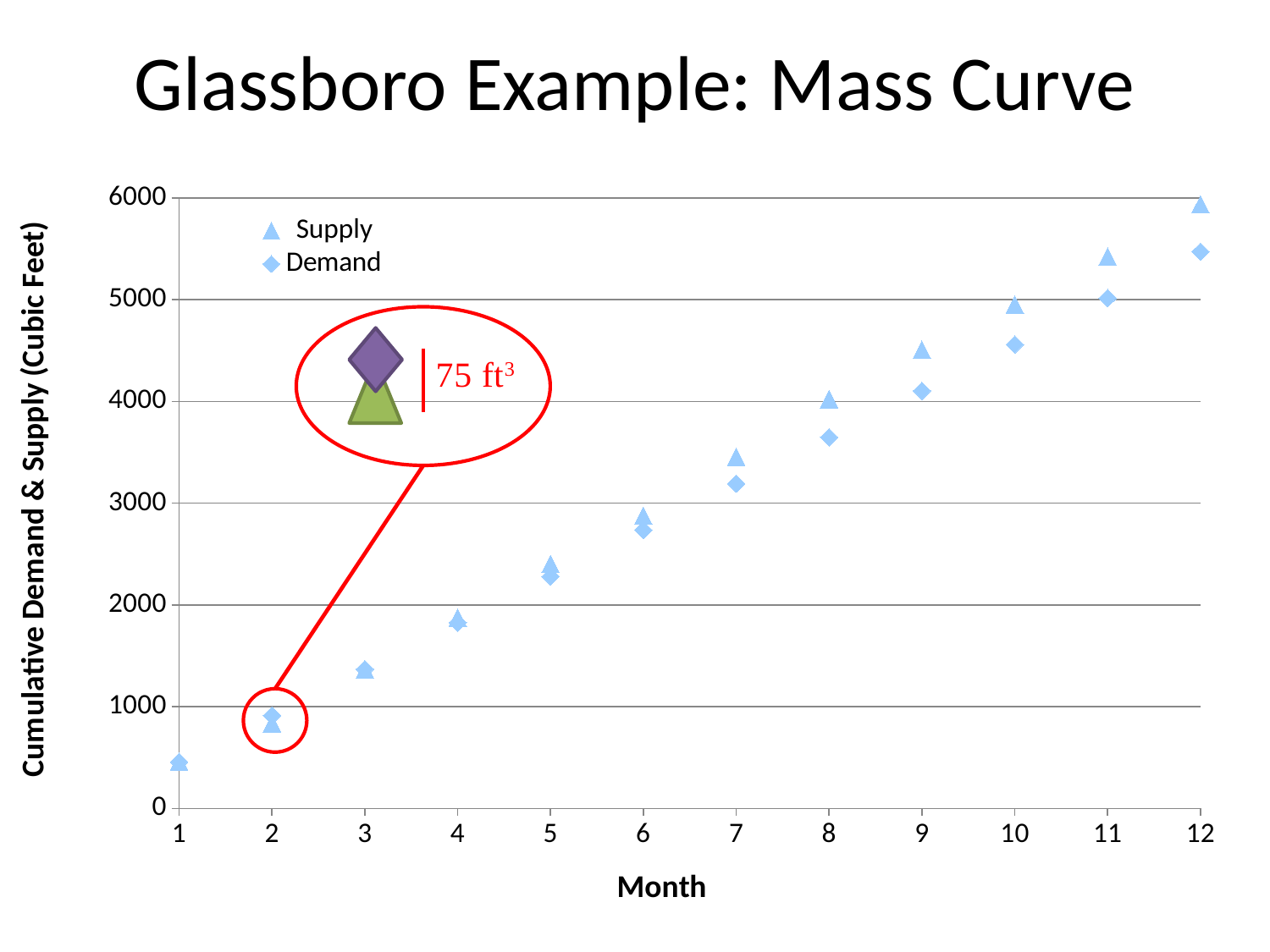
At month 12, which series has the larger value, Supply or Demand? Supply What kind of chart is shown on the slide? scatter chart How many series does the chart legend list? 2 What is the title of the y axis? Cumulative Demand & Supply (Cubic Feet) Do the Supply values rise or fall as the month increases? rise How many months are plotted along the x axis? 12 Is the Demand value at month 8 greater or less than 4000? less Is the Supply value at month 4 greater or less than 2000? less At month 9, which series has the larger value, Supply or Demand? Supply What difference is labelled in the red zoomed-in circle for month 2? 75 ft³ Is the Demand value at month 7 greater or less than 3000? greater